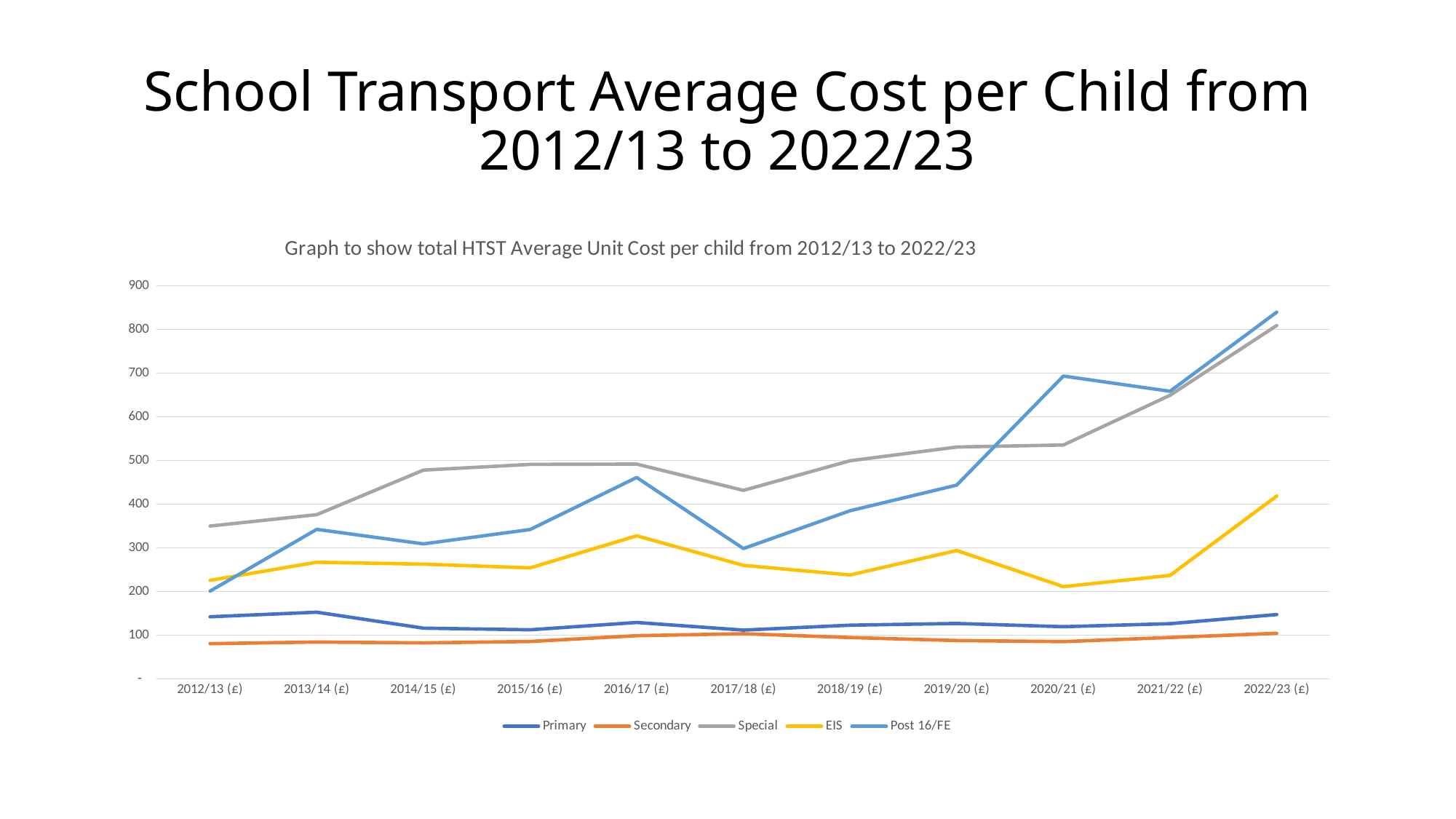
How many series does the legend list? 5 Which series has the lowest values across the whole period? Secondary Is the value for Post 16/FE in 2022/23 greater or less than 800? greater What is the title printed above the chart? Graph to show total HTST Average Unit Cost per child from 2012/13 to 2022/23 Which series has the highest value in 2022/23? Post 16/FE In 2020/21, which is larger: Special or Post 16/FE? Post 16/FE How many years are shown along the x axis? 11 Which series has the highest value in 2012/13? Special Is the value for EIS in 2020/21 greater or less than 300? less Does the Post 16/FE line rise or fall from 2019/20 to 2020/21? Rise What kind of chart is shown on the slide? Line chart Is the value for Special in 2017/18 greater or less than 500? less